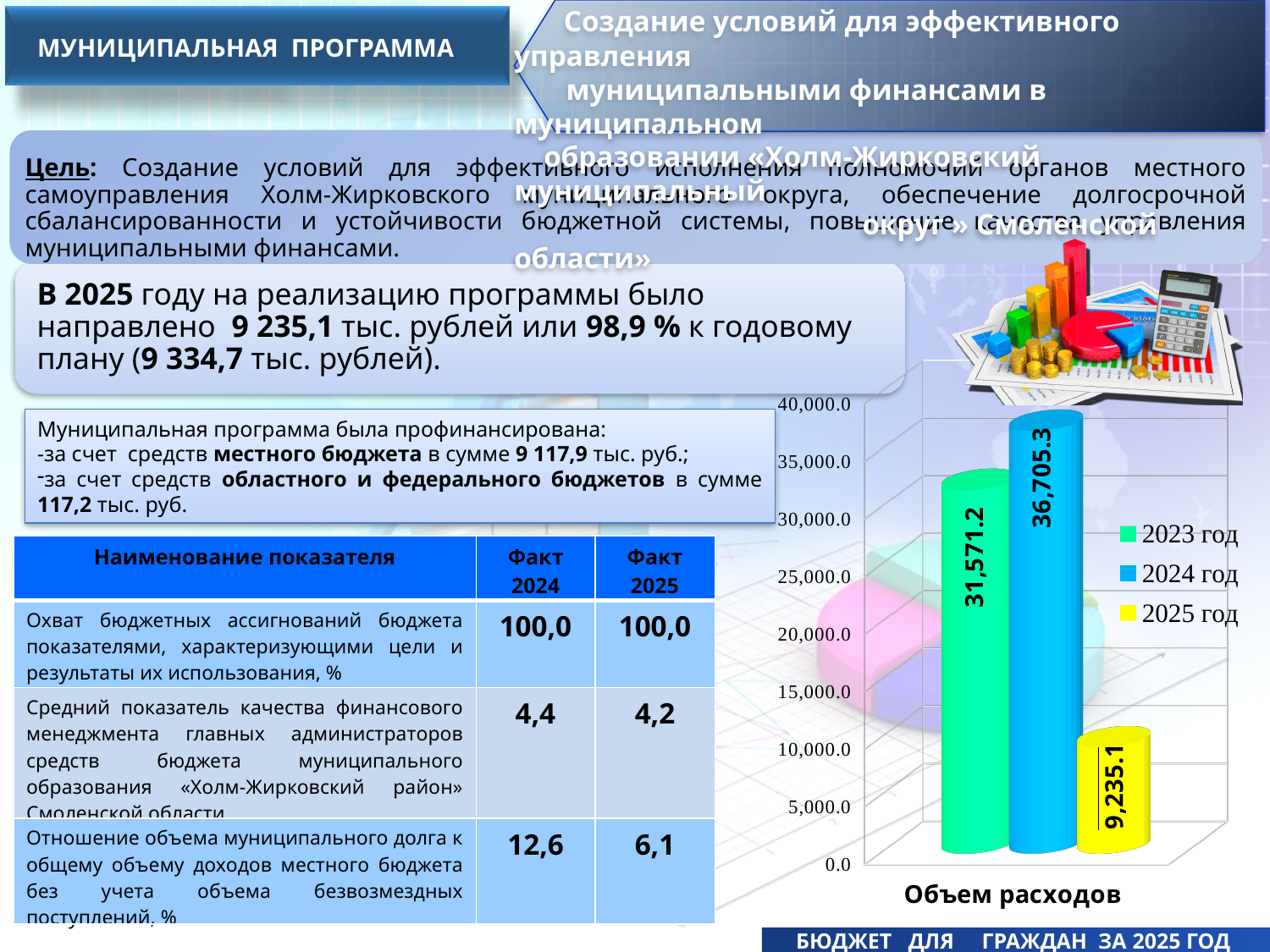
What is the value shown for 2024 год in the chart? 36,705.3 Is the value for 2025 год greater or less than 10,000.0? less What is the difference between the values for 2023 год and 2025 год? 22,336.1 Which is larger, the value for 2023 год or the value for 2025 год? 2023 год Which year has the highest value in the chart? 2024 год Which year has the lowest value in the chart? 2025 год How many series does the chart legend list? 3 What is the value shown for 2025 год in the chart? 9,235.1 What kind of chart is shown on the slide? bar chart What is the difference between the values for 2024 год and 2023 год? 5,134.1 What is the value shown for 2023 год in the chart? 31,571.2 What is the category label shown below the chart? Объем расходов